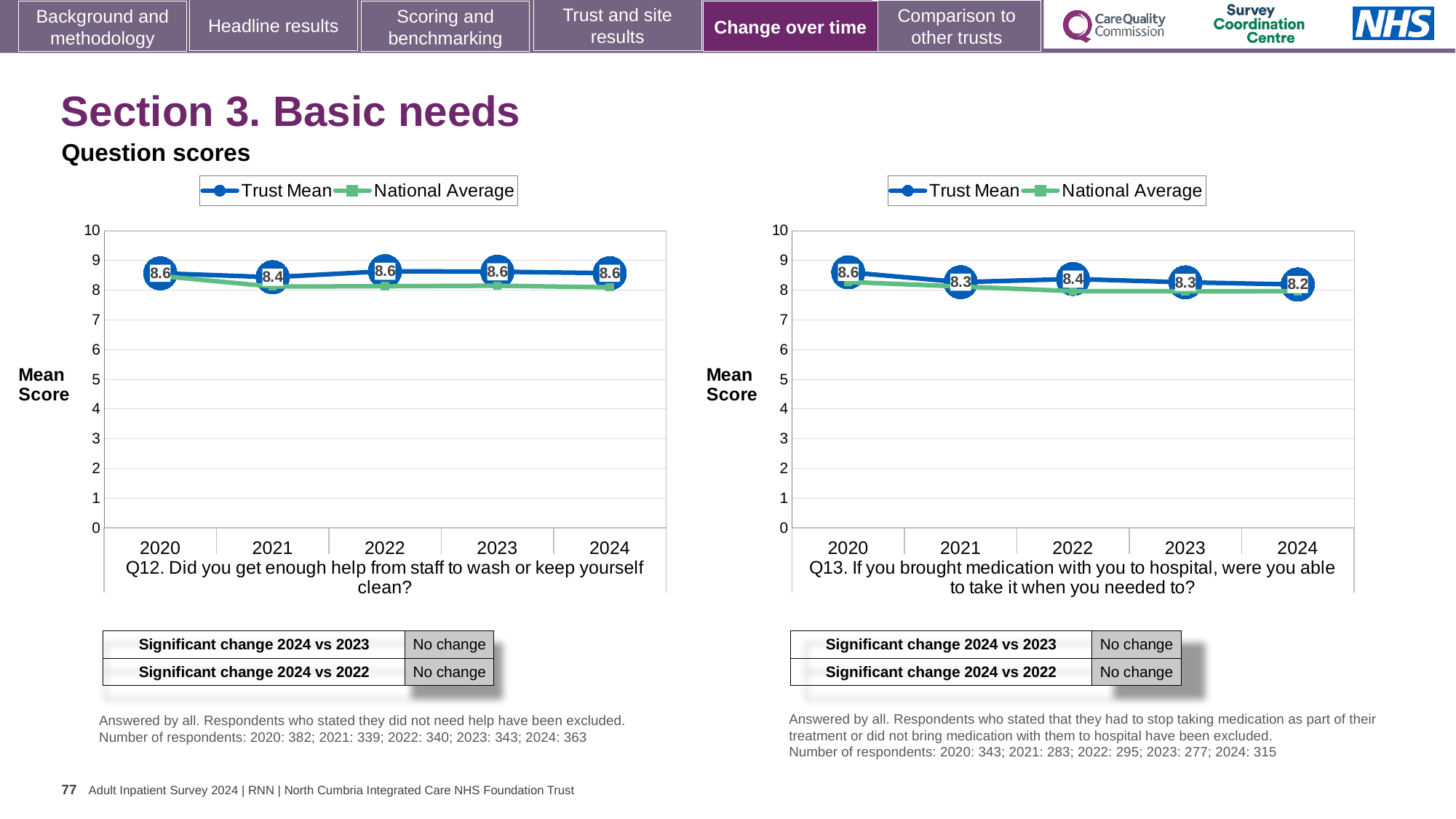
In the Q12 chart (left), what is the Trust Mean for 2021? 8.4 In the Q13 chart (right), is the Trust Mean for 2020 larger or smaller than the Trust Mean for 2024? larger How many years are plotted on the x axis of the Q13 chart (right)? 5 In the Q13 chart (right), what is the difference between the Trust Mean for 2020 and 2024? 0.4 In the Q12 chart (left), is the National Average for 2024 greater or less than 7? greater How many series does the legend of the Q12 chart (left) list? 2 In the Q13 chart (right), what is the Trust Mean for 2024? 8.2 In the Q13 chart (right), what is the Trust Mean for 2022? 8.4 What kind of chart is the Q13 chart (right)? Line chart In the Q12 chart (left), which year has the lowest Trust Mean? 2021 In the Q12 chart (left), what is the Trust Mean for 2024? 8.6 In the Q13 chart (right), which year has the lowest Trust Mean? 2024